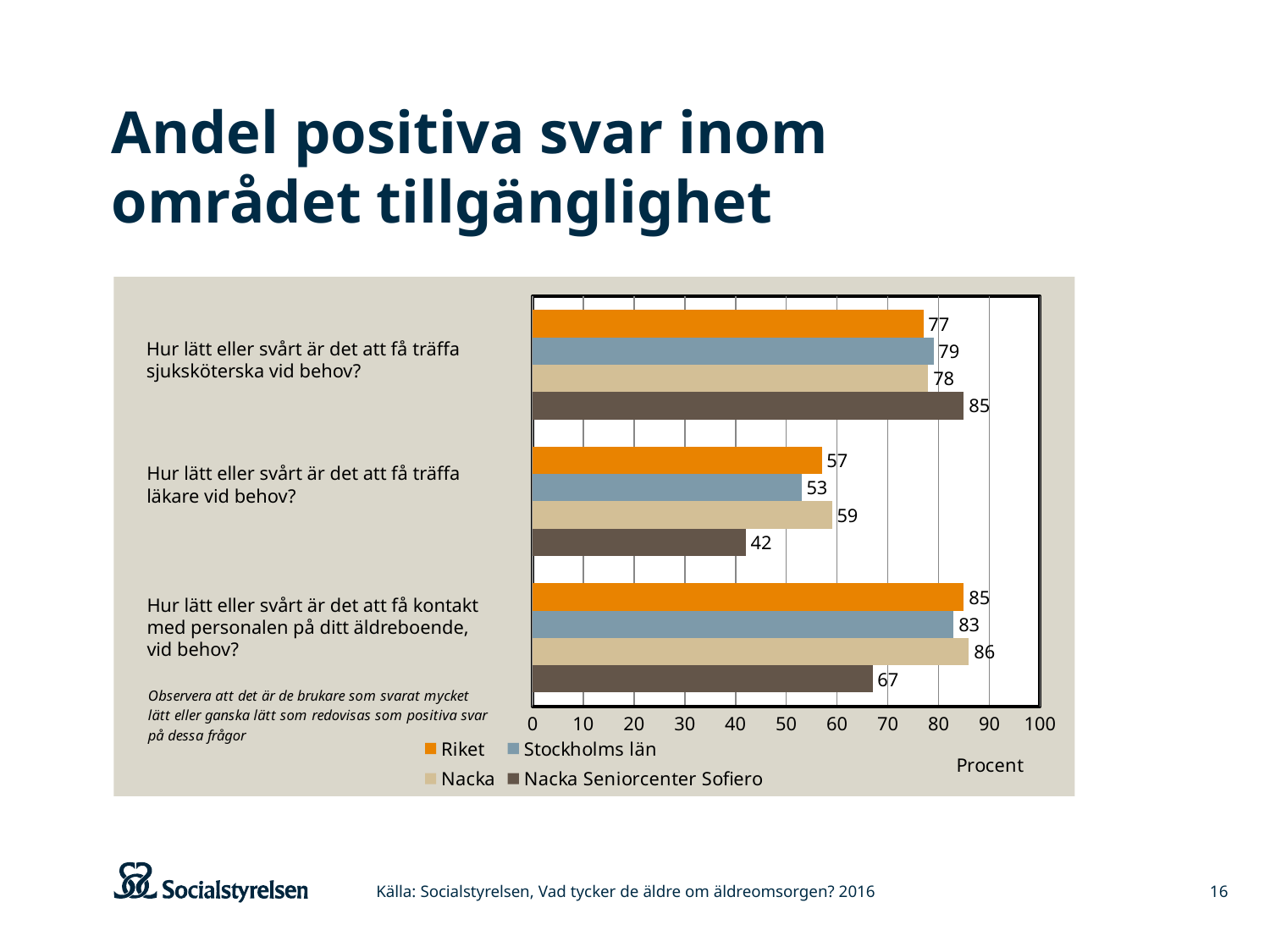
What is the label of the x axis? Procent How many series does the legend list? 4 Which is larger for "Hur lätt eller svårt är det att få träffa läkare vid behov?": Riket or Stockholms län? Riket What is the value for Nacka Seniorcenter Sofiero for "Hur lätt eller svårt är det att få träffa sjuksköterska vid behov?"? 85 What kind of chart is shown on the slide? Bar chart What is the difference between Nacka and Nacka Seniorcenter Sofiero for "Hur lätt eller svårt är det att få träffa läkare vid behov?"? 17 How many question categories are shown on the chart? 3 What is the value for Riket for "Hur lätt eller svårt är det att få träffa läkare vid behov?"? 57 What is the difference between Nacka and Nacka Seniorcenter Sofiero for "Hur lätt eller svårt är det att få kontakt med personalen på ditt äldreboende, vid behov?"? 19 What is the value for Stockholms län for "Hur lätt eller svårt är det att få kontakt med personalen på ditt äldreboende, vid behov?"? 83 Which series has the lowest value for "Hur lätt eller svårt är det att få träffa läkare vid behov?"? Nacka Seniorcenter Sofiero Which series has the highest value for "Hur lätt eller svårt är det att få träffa sjuksköterska vid behov?"? Nacka Seniorcenter Sofiero